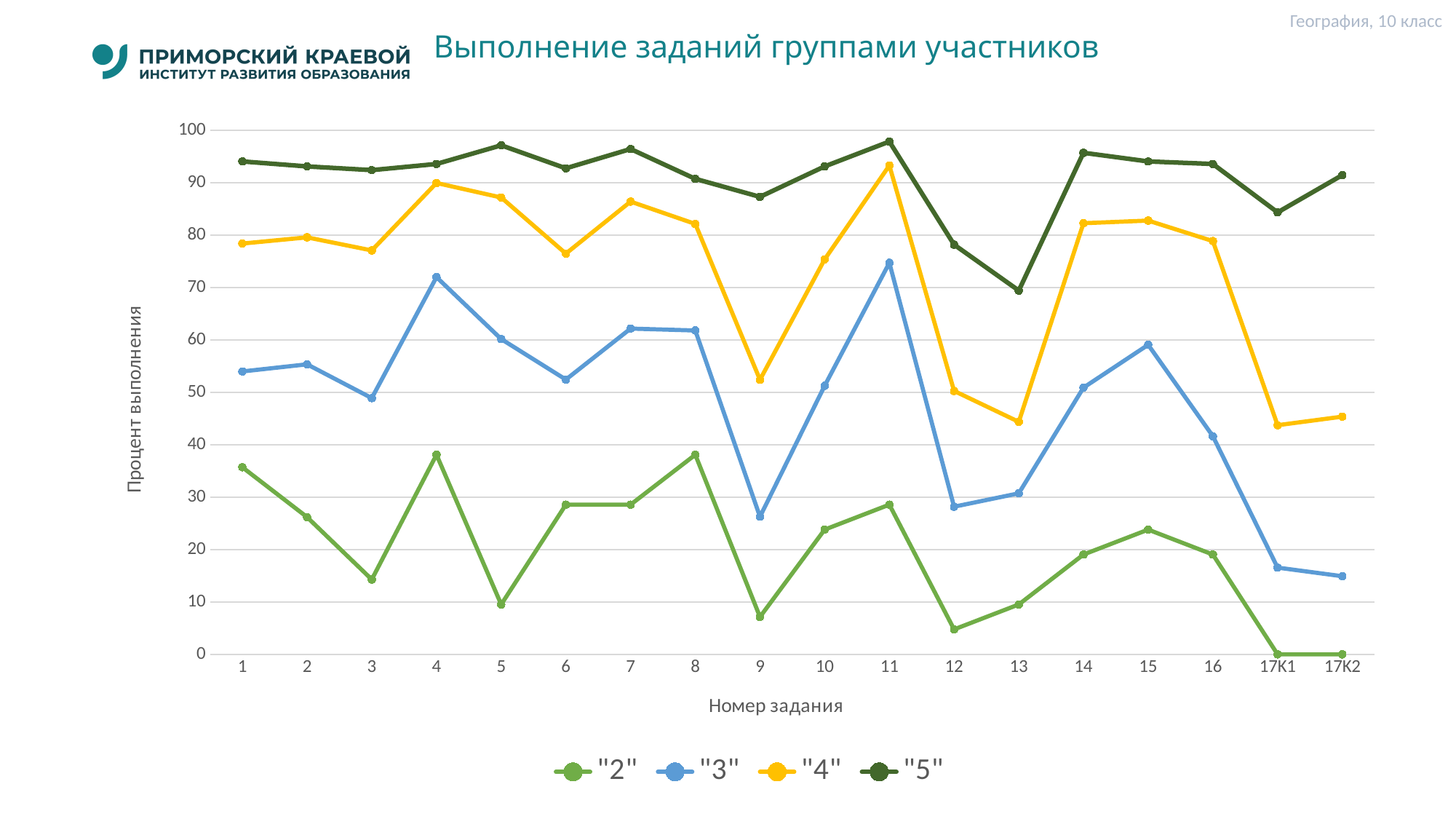
How many task numbers are shown along the x axis? 18 Is the value for series "5" at task 11 greater or less than 90? greater Is the value for series "2" at task 9 greater or less than 10? less Which is larger for series "3": the value at task 4 or at task 5? task 4 What kind of chart is shown on the slide? line chart At which task does series "4" have its highest value? 11 How many series does the legend list? 4 What is the title of the chart? Выполнение заданий группами участников Is the value for series "4" at task 13 greater or less than 50? less What is the value for series "2" at task 17К1? 0 At which task does series "5" have its lowest value? 13